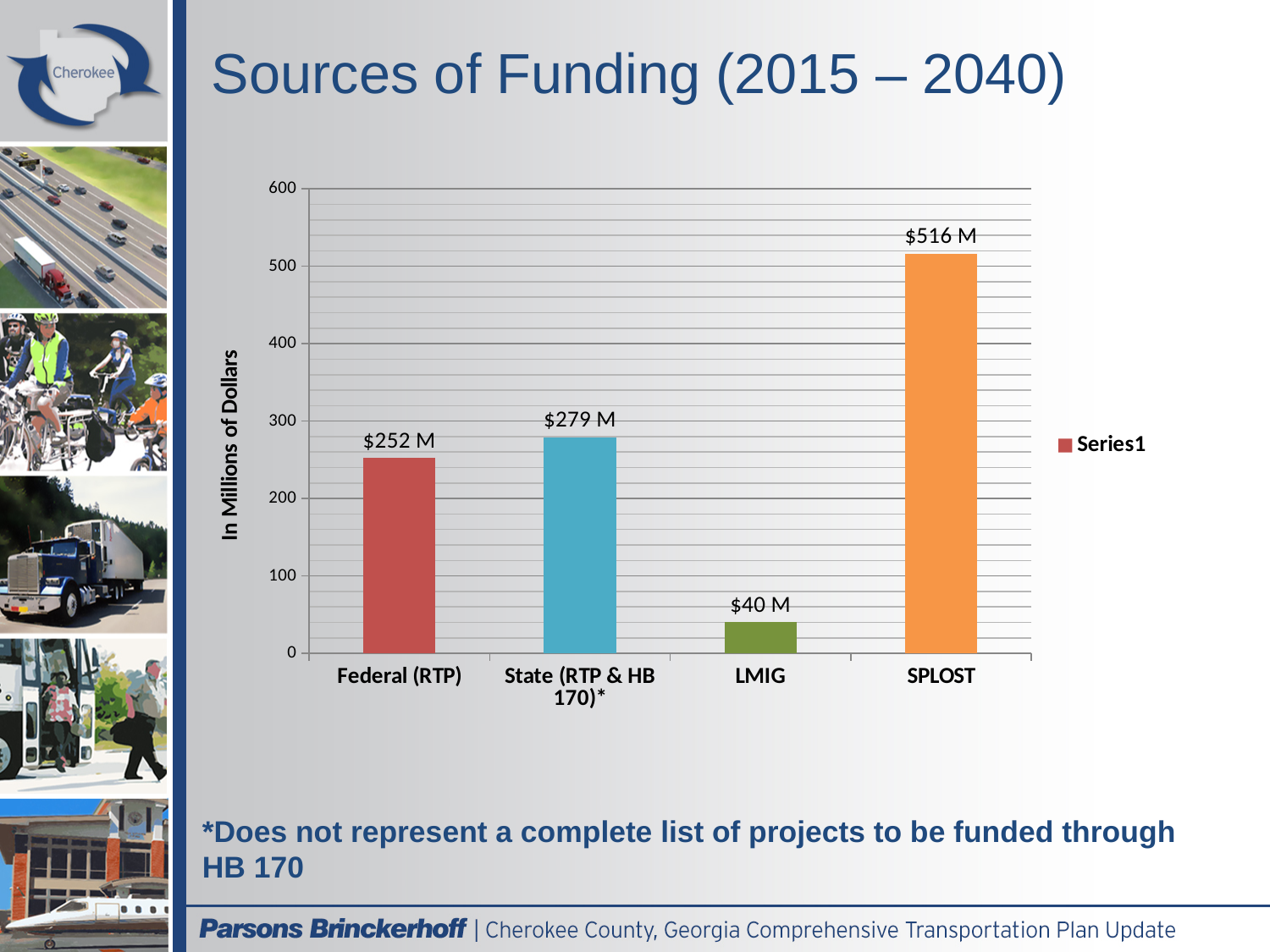
What is the value for Federal (RTP)? $252 M Which funding source has the lowest value? LMIG What is the value for State (RTP & HB 170)*? $279 M What is the value for LMIG? $40 M What is the label on the vertical axis of the chart? In Millions of Dollars Is the value for SPLOST greater or less than 500? greater Which funding source has the highest value? SPLOST How many funding sources are shown on the chart? 4 What is the difference between the SPLOST value and the Federal (RTP) value? $264 M Which is larger, the value for State (RTP & HB 170)* or the value for Federal (RTP)? State (RTP & HB 170)* What kind of chart is shown on the slide? bar chart What is the value for SPLOST? $516 M